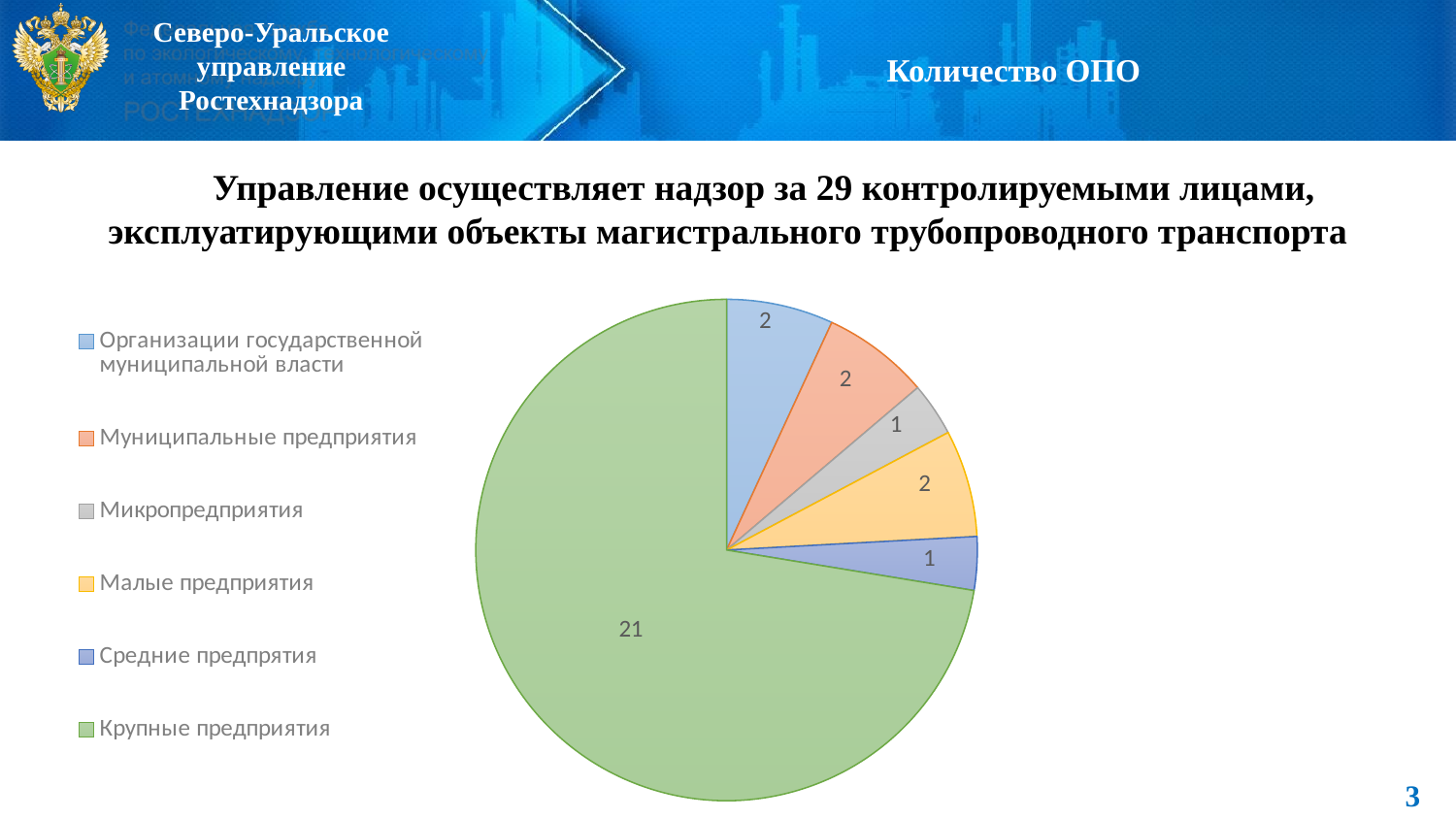
How many slices does the pie chart have? 6 What colour is the slice for Крупные предприятия? green What is the value for Малые предприятия? 2 Which is larger, the value for Муниципальные предприятия or the value for Микропредприятия? Муниципальные предприятия What is the value for Крупные предприятия? 21 How many entries does the legend list? 6 Which category has the largest slice? Крупные предприятия What is the value for Микропредприятия? 1 What is the difference between the values for Крупные предприятия and Малые предприятия? 19 What is the total of all slices in the pie chart? 29 What is the value for Средние предпрятия? 1 What kind of chart is shown on the slide? pie chart